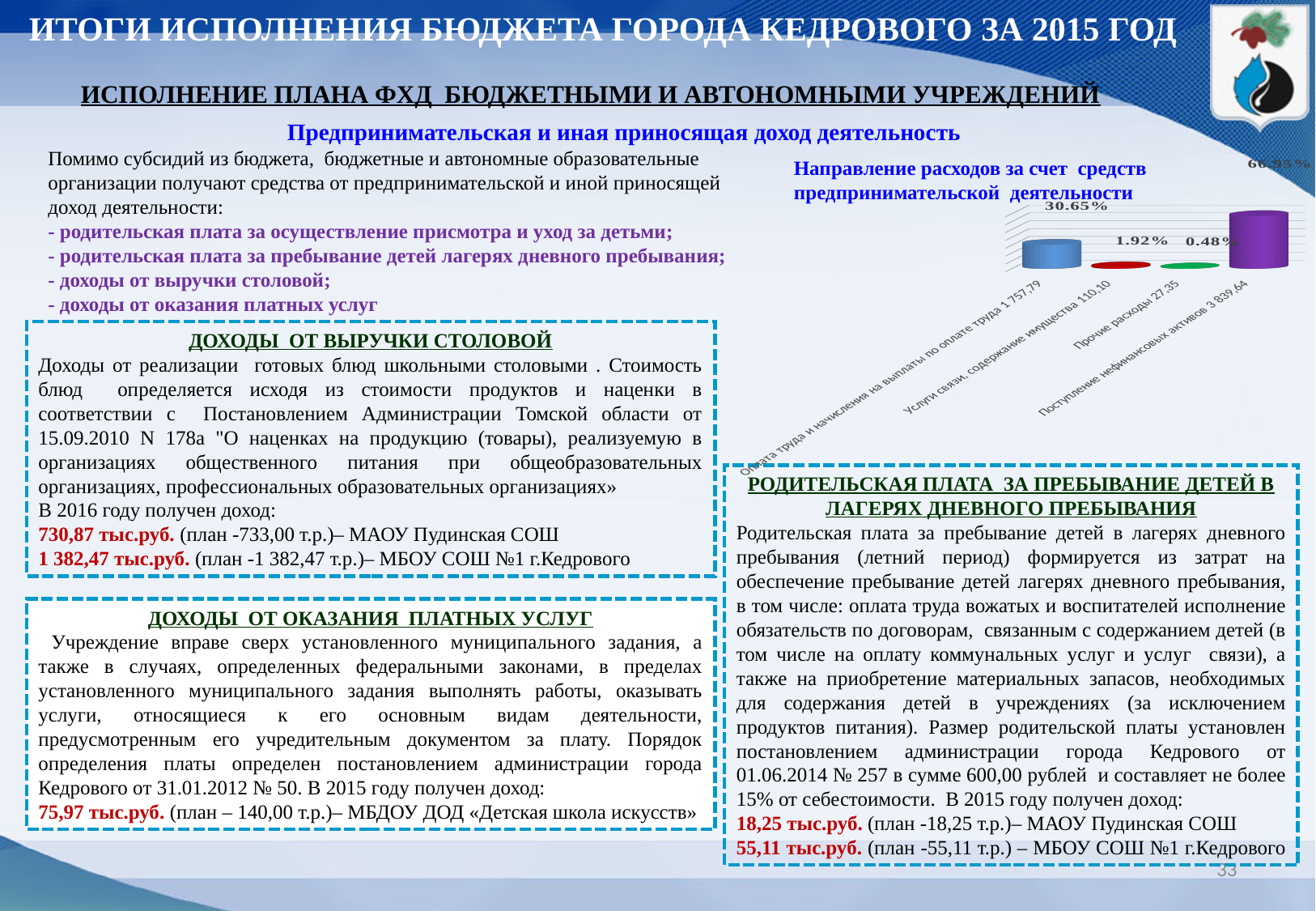
In the chart 'Направление расходов за счет средств предпринимательской деятельности', what percentage is shown for 'Прочие расходы'? 0.48% In the chart 'Направление расходов за счет средств предпринимательской деятельности', which category has the highest value? Поступление нефинансовых активов In the chart 'Направление расходов за счет средств предпринимательской деятельности', which category has the lowest value? Прочие расходы In the chart 'Направление расходов за счет средств предпринимательской деятельности', what amount is written in the category label for 'Прочие расходы'? 27,35 In the chart 'Направление расходов за счет средств предпринимательской деятельности', what percentage is shown for 'Оплата труда и начисления на выплаты по оплате труда'? 30.65% In the chart 'Направление расходов за счет средств предпринимательской деятельности', what is the difference between the values for 'Оплата труда и начисления на выплаты по оплате труда' and 'Услуги связи, содержание имущества'? 28.73% How many categories are plotted in the chart 'Направление расходов за счет средств предпринимательской деятельности'? 4 In the chart 'Направление расходов за счет средств предпринимательской деятельности', which is larger: 'Оплата труда и начисления на выплаты по оплате труда' or 'Услуги связи, содержание имущества'? Оплата труда и начисления на выплаты по оплате труда What kind of chart is shown under the title 'Направление расходов за счет средств предпринимательской деятельности'? bar chart In the chart 'Направление расходов за счет средств предпринимательской деятельности', what percentage is shown for 'Услуги связи, содержание имущества'? 1.92% What is the title of the chart on the right side of the slide? Направление расходов за счет средств предпринимательской деятельности In the chart 'Направление расходов за счет средств предпринимательской деятельности', what is the difference between the values for 'Услуги связи, содержание имущества' and 'Прочие расходы'? 1.44%